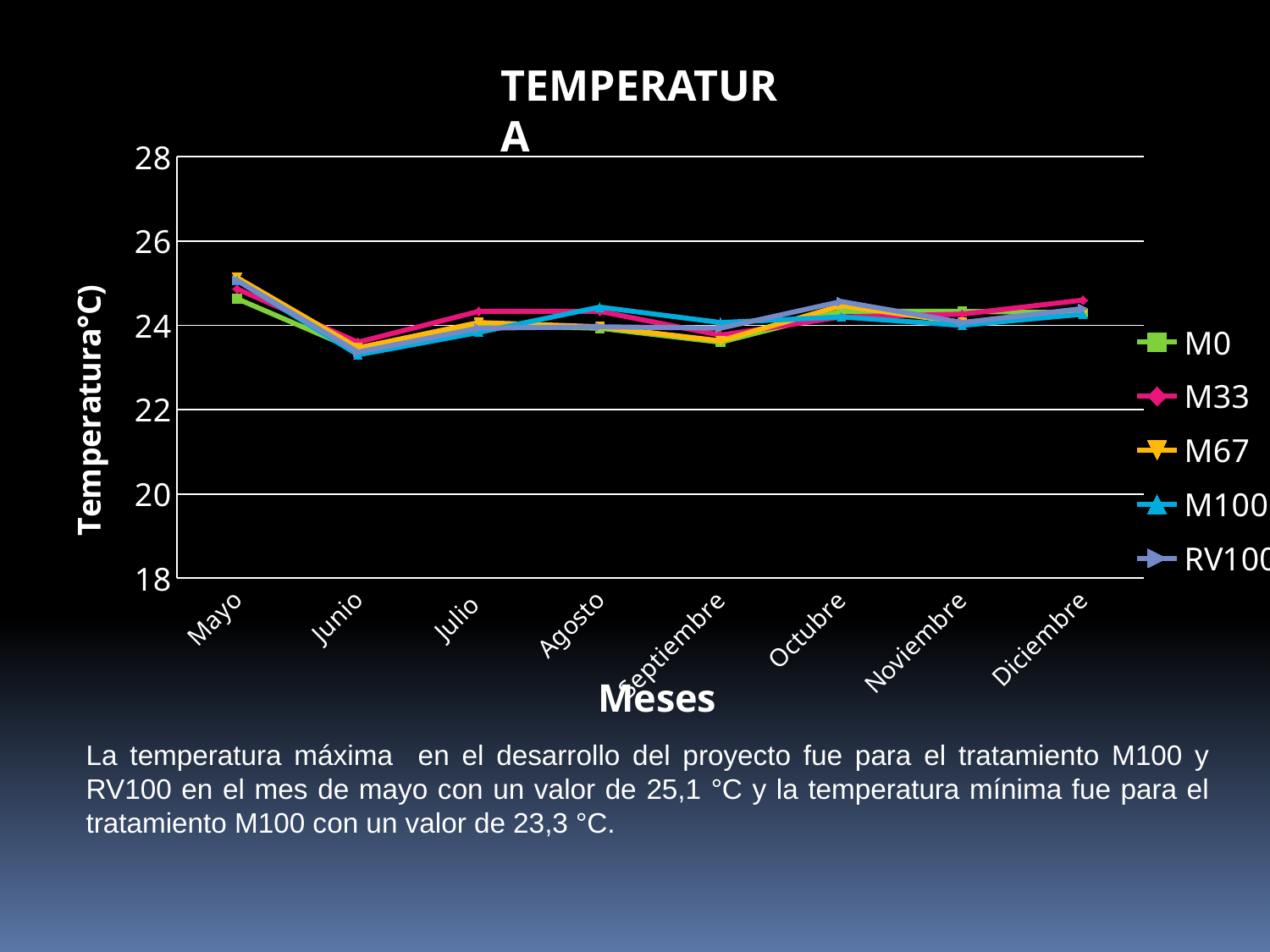
Is the value for RV100 in Mayo greater or less than 24? greater How many series does the legend list? 5 Is the value for M33 in Diciembre greater or less than 22? greater In which month is the temperature for M0 highest? Mayo What is the label of the x axis? Meses Is the value for M100 in Junio greater or less than 24? less What is the title of the chart? TEMPERATURA Do the temperatures rise or fall from Mayo to Junio? fall What kind of chart is shown on the slide? line chart In which month is the temperature for M100 lowest? Junio How many months are shown on the x axis? 8